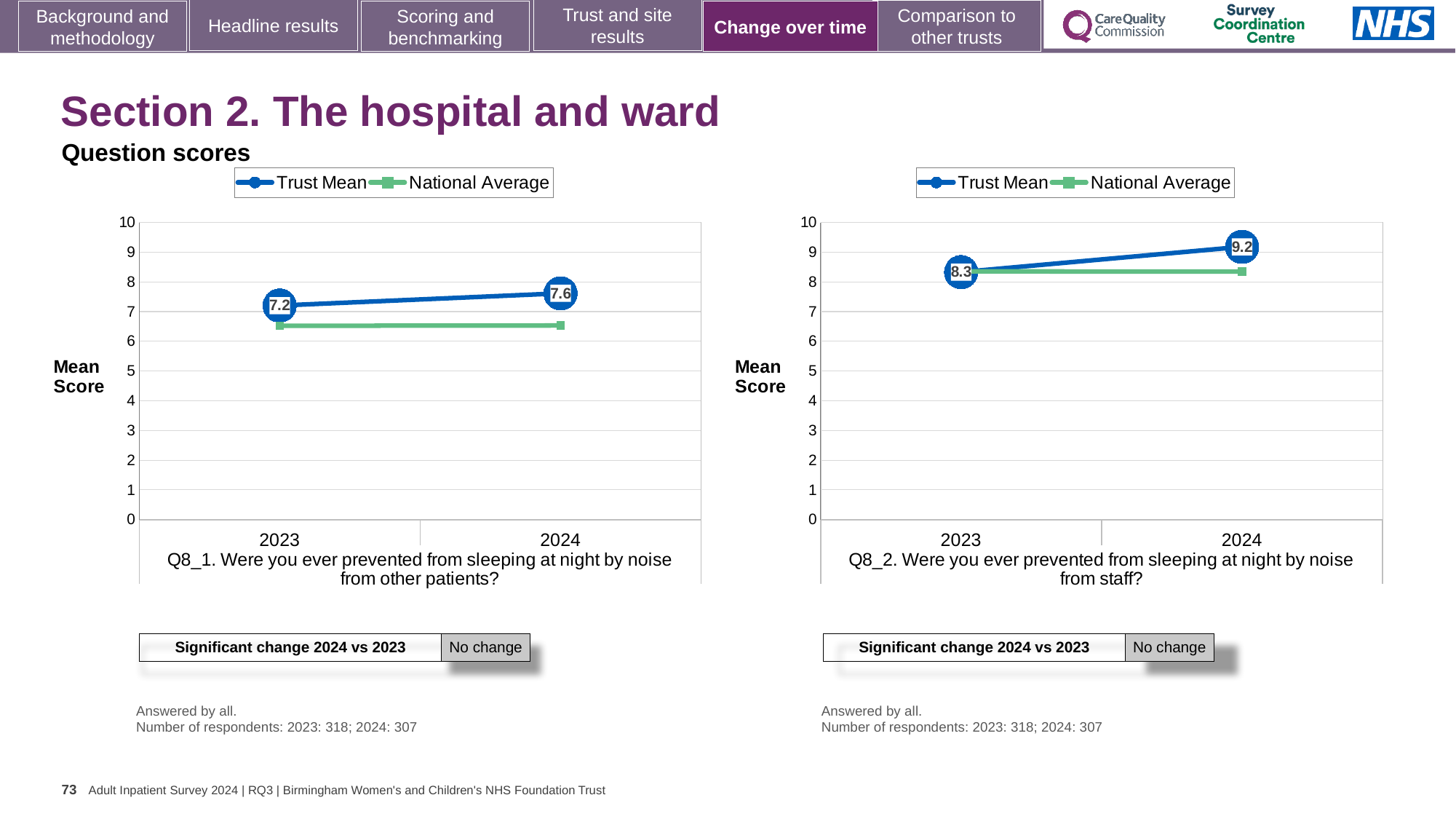
In the Q8_1 chart (left), which is larger in 2024, the Trust Mean or the National Average? Trust Mean How many series does the legend of the Q8_2 chart (right) list? 2 In the Q8_2 chart (right), by how much did the Trust Mean change from 2023 to 2024? 0.9 In the Q8_2 chart (right), does the Trust Mean rise or fall from 2023 to 2024? rise In the Q8_2 chart (right), what is the Trust Mean score for 2024? 9.2 In the Q8_1 chart (left), is the National Average for 2024 greater or less than 7? less In the Q8_2 chart (right), what is the Trust Mean score for 2023? 8.3 What kind of chart is the Q8_1 chart (left)? line chart In the Q8_1 chart (left), what is the Trust Mean score for 2023? 7.2 In the Q8_2 chart (right), is the National Average for 2023 greater or less than 8? greater In the Q8_1 chart (left), by how much did the Trust Mean change from 2023 to 2024? 0.4 In the Q8_1 chart (left), what is the Trust Mean score for 2024? 7.6